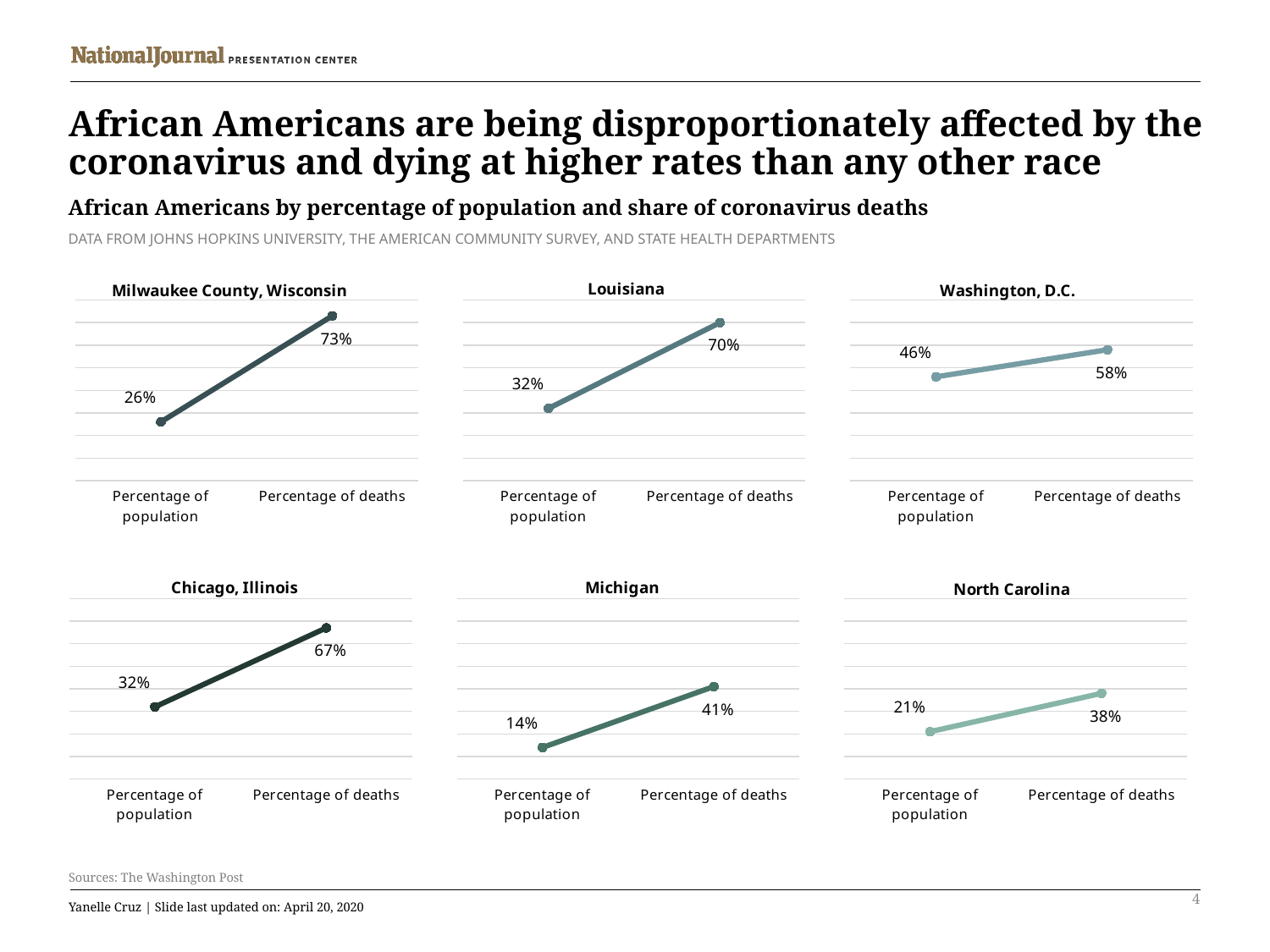
In the Michigan chart, do the values rise or fall from percentage of population to percentage of deaths? Rise In the Washington, D.C. chart, what is the percentage of deaths? 58% In the Milwaukee County, Wisconsin chart, what is the percentage of deaths? 73% In the Michigan chart, what is the percentage of population? 14% In the Washington, D.C. chart, which is larger, the percentage of population or the percentage of deaths? Percentage of deaths What kind of chart is the Chicago, Illinois chart? Line chart In the Louisiana chart, what is the percentage of population? 32% How many data points are plotted in the North Carolina chart? 2 In the Louisiana chart, what is the difference between the percentage of deaths and the percentage of population? 38% In the Chicago, Illinois chart, what is the difference between the percentage of deaths and the percentage of population? 35% How many charts are shown on the slide? 6 In the North Carolina chart, what is the percentage of deaths? 38%